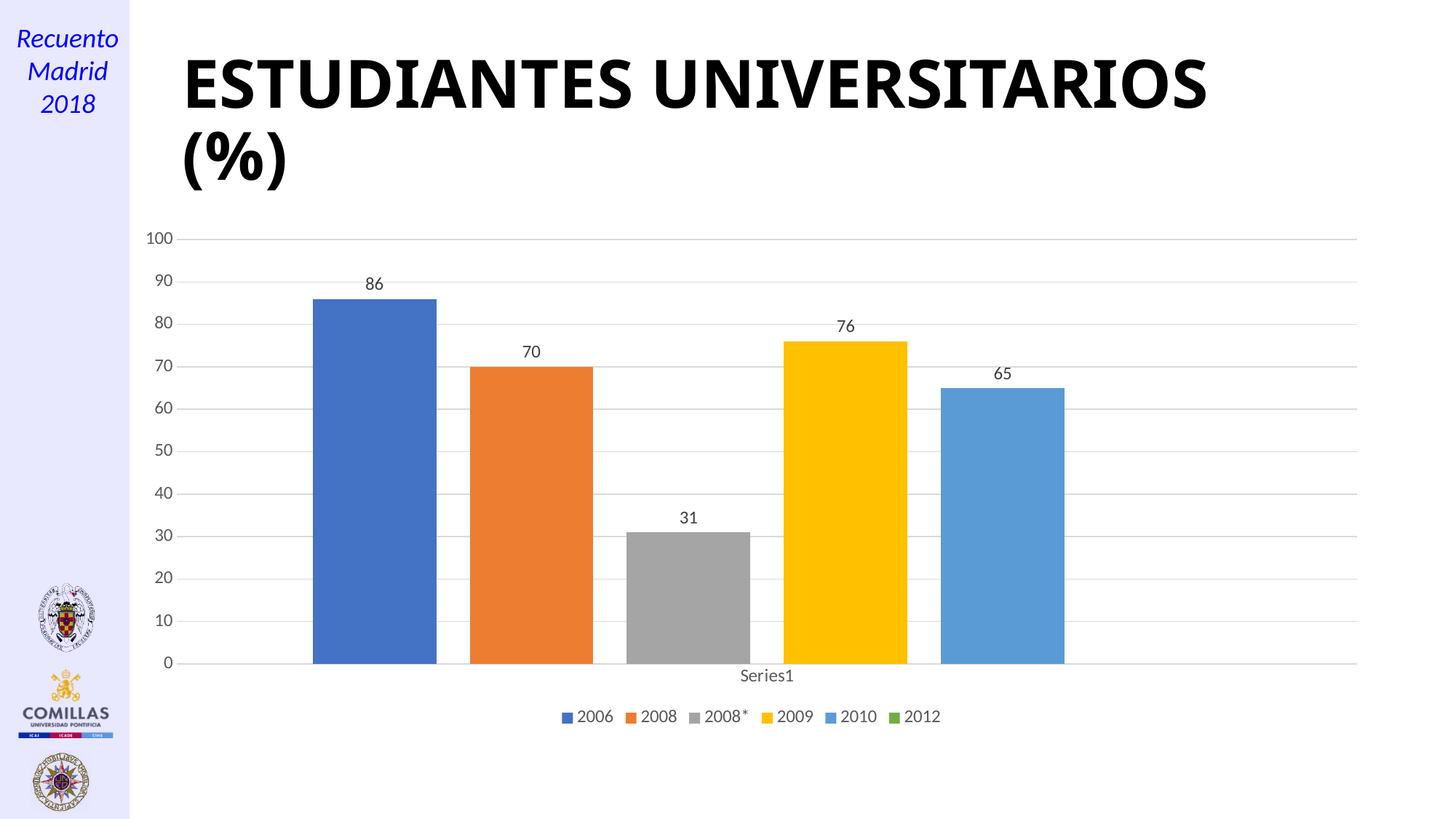
How many series does the legend list? 6 What is the difference between the values for 2009 and 2008? 6 Which series has the highest value? 2006 What is the value for 2010? 65 What is the title of the chart? ESTUDIANTES UNIVERSITARIOS (%) What kind of chart is shown on the slide? bar chart Which series has the lowest plotted value? 2008* What is the value for 2006? 86 What is the difference between the values for 2006 and 2010? 21 Which is larger, the value for 2008 or the value for 2009? 2009 What is the value for 2008*? 31 How many bars are plotted in the chart? 5